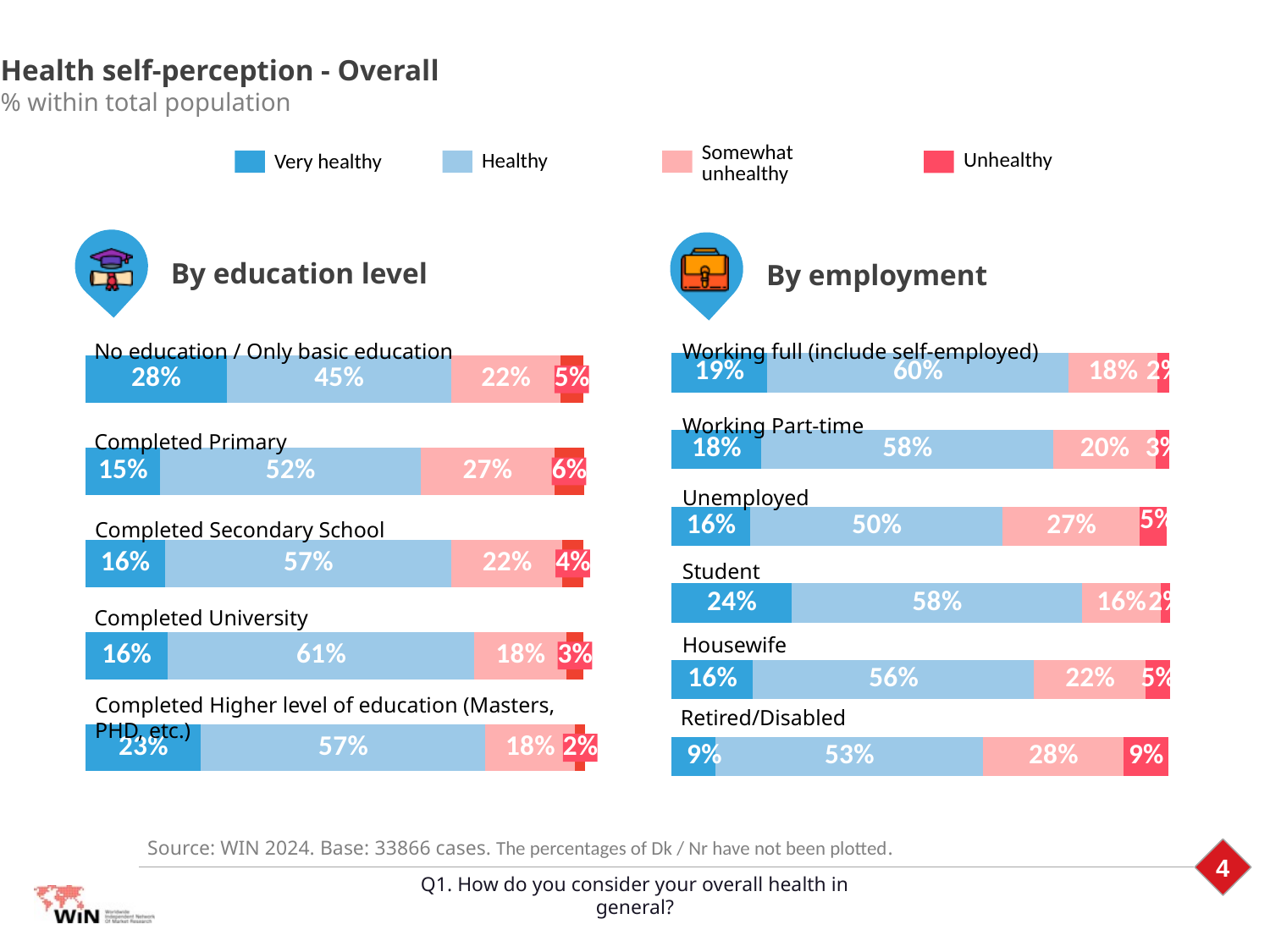
How many series does the legend list? 4 In the 'By employment' chart, what percentage of students say they are very healthy? 24% What type of chart is used in the 'By employment' section? Stacked bar chart In the 'By education level' chart, which education level has the highest 'Very healthy' share? No education / Only basic education In the 'By employment' chart, which employment group has the lowest 'Very healthy' share? Retired/Disabled In the 'By employment' chart, is the 'Healthy' value larger for Working full (include self-employed) or for Unemployed? Working full (include self-employed) In the 'By education level' chart, what percentage of people with no education / only basic education say they are very healthy? 28% In the 'By education level' chart, what is the difference between the 'Somewhat unhealthy' values for Completed Primary and Completed University? 9% In the 'By education level' chart, what is the 'Healthy' value for Completed University? 61% In the 'By education level' chart, how many education categories are shown? 5 In the 'By education level' chart, which education level has the lowest 'Unhealthy' share? Completed Higher level of education (Masters, PHD, etc.) In the 'By employment' chart, what is the 'Somewhat unhealthy' value for Retired/Disabled? 28%